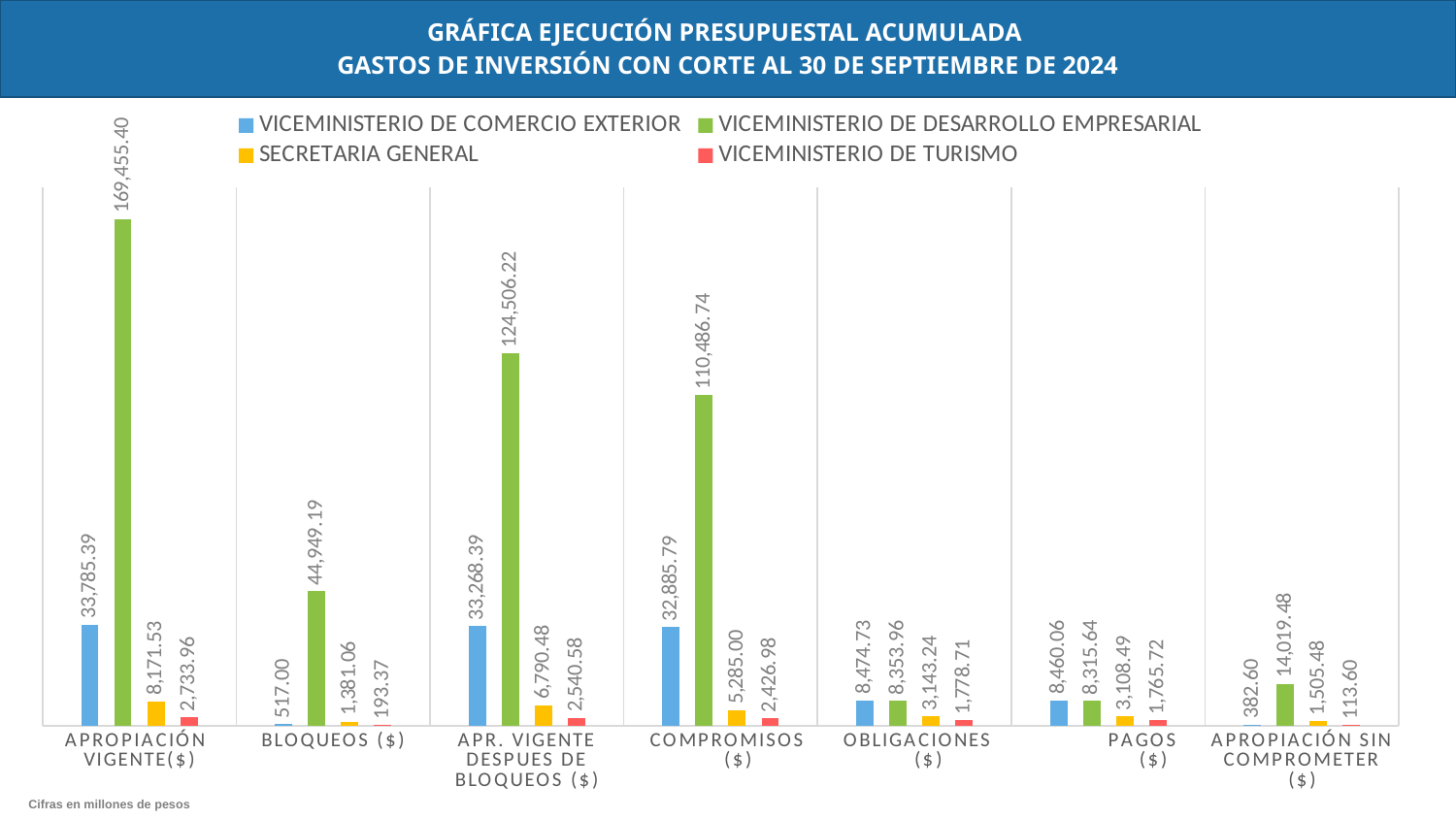
What is the value for VICEMINISTERIO DE COMERCIO EXTERIOR in the PAGOS ($) category? 8,460.06 Which series has the highest value in the APR. VIGENTE DESPUES DE BLOQUEOS ($) category? VICEMINISTERIO DE DESARROLLO EMPRESARIAL What is the value for VICEMINISTERIO DE TURISMO in the BLOQUEOS ($) category? 193.37 How many series does the legend list? 4 How many categories are shown on the x axis? 7 What type of chart is shown on the slide? Bar chart Which is larger for VICEMINISTERIO DE COMERCIO EXTERIOR: the value for COMPROMISOS ($) or the value for OBLIGACIONES ($)? COMPROMISOS ($) What unit are the figures in, according to the note at the bottom of the slide? Millones de pesos What is the value for SECRETARIA GENERAL in the COMPROMISOS ($) category? 5,285.00 Which series has the lowest value in the APROPIACIÓN SIN COMPROMETER ($) category? VICEMINISTERIO DE TURISMO What is the value for VICEMINISTERIO DE DESARROLLO EMPRESARIAL in the APROPIACIÓN VIGENTE($) category? 169,455.40 What is the difference between the VICEMINISTERIO DE DESARROLLO EMPRESARIAL values for APROPIACIÓN VIGENTE($) and BLOQUEOS ($)? 124,506.21